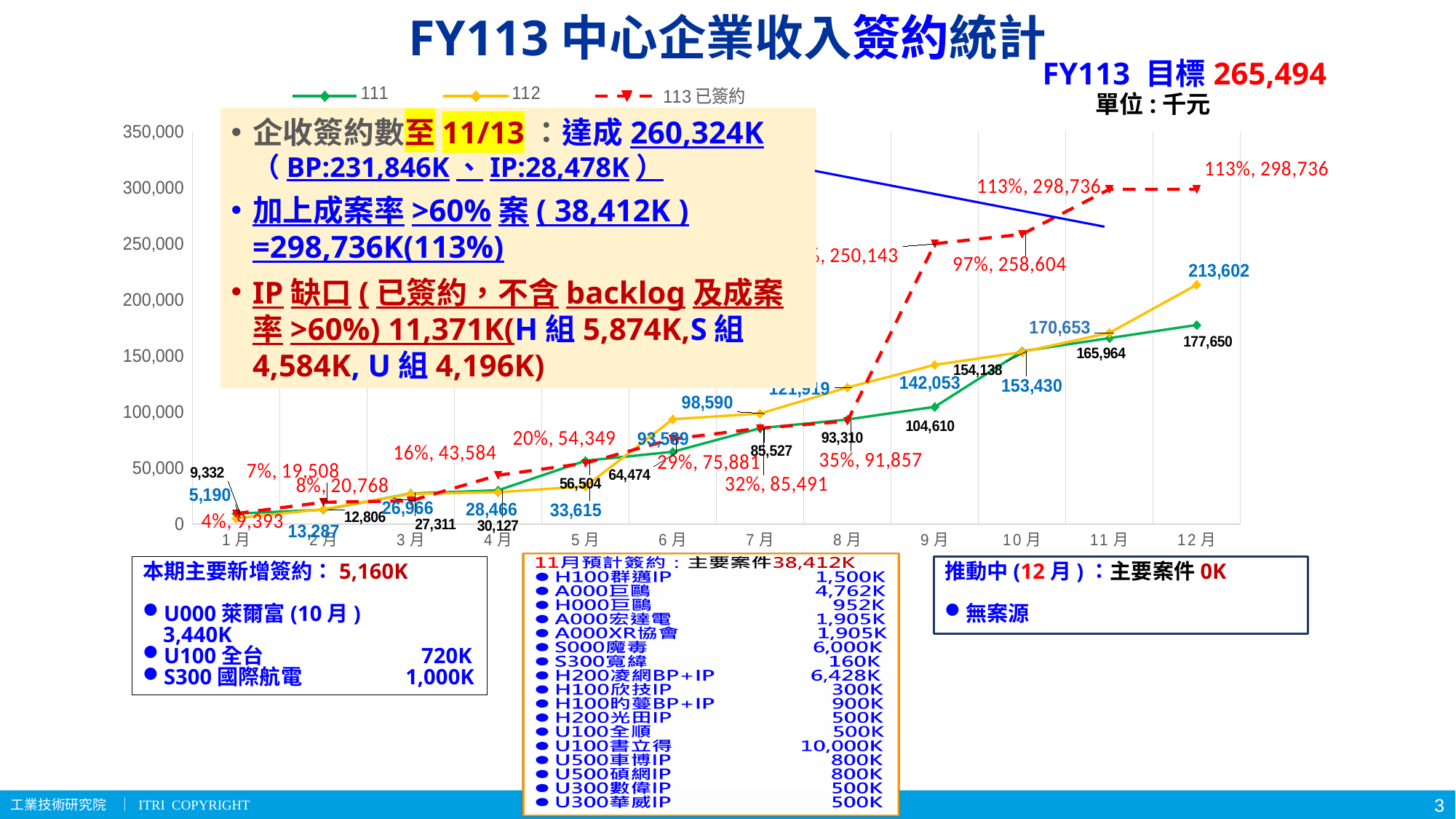
What is the signed amount for 113 已簽約 at 10月? 258,604 What is the FY113 target shown on the slide? 265,494 What is the difference between series 112 and series 111 at 12月? 35,952 What is the value of series 112 at 1月? 5,190 How many months are shown on the x axis? 12 What is the value of series 112 at 12月? 213,602 What is the value of series 111 at 11月? 165,964 At 12月, which series is larger, 111 or 112? 112 How many series does the legend list? 3 What is the value of series 111 at 12月? 177,650 What kind of chart is shown on the slide? line chart Is the value for 113 已簽約 at 9月 greater or less than 200,000? greater